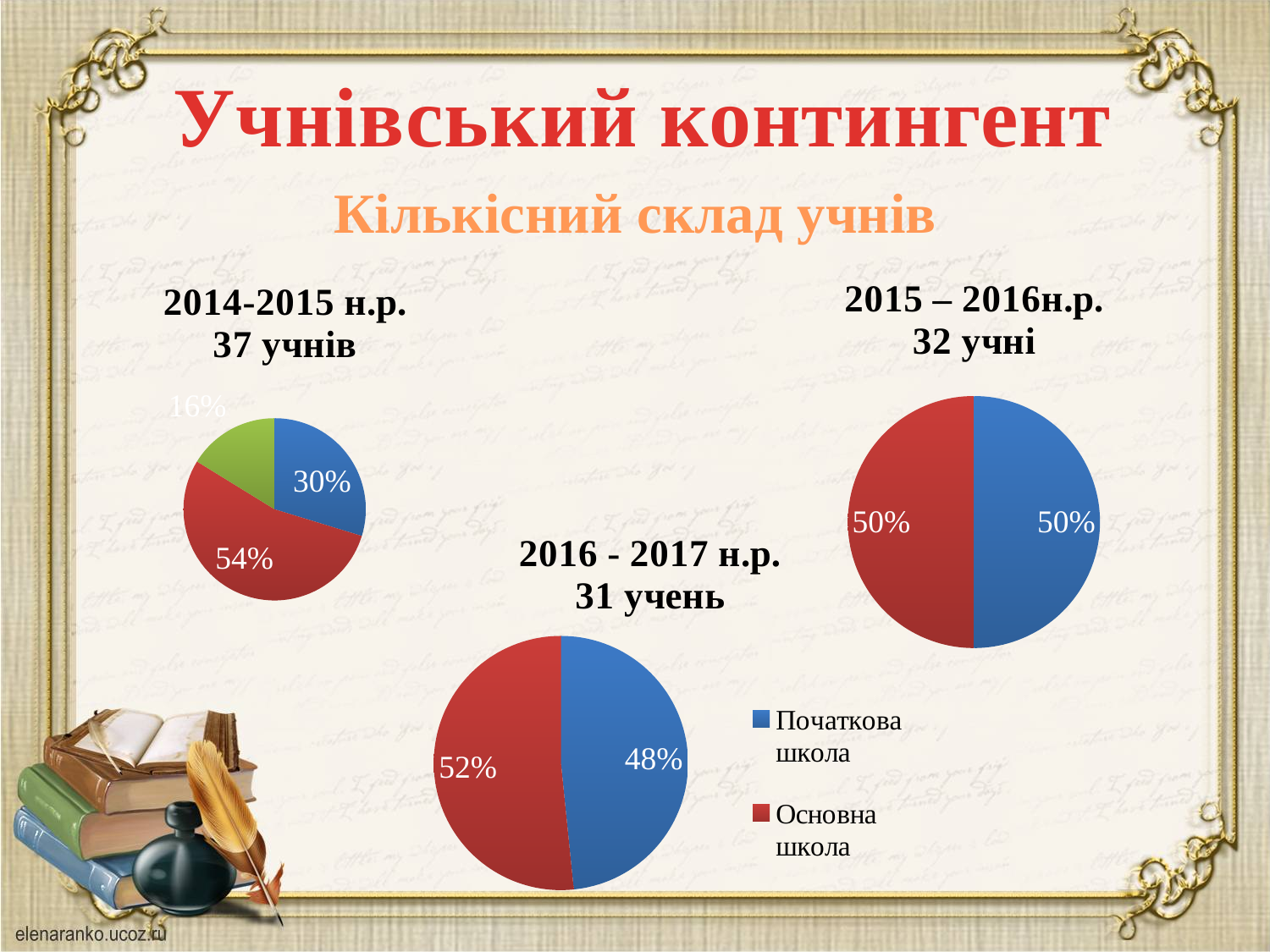
What kind of charts are shown on the slide? Pie charts How many pie charts are on the slide? 3 In the 2014-2015 н.р. pie chart, what share is shown for Початкова школа (blue slice)? 30% In the 2014-2015 н.р. pie chart, what share is shown for the green slice? 16% In the 2014-2015 н.р. pie chart, which slice is the largest? Основна школа (54%) In the 2014-2015 н.р. pie chart, which slice is the smallest? The green slice (16%) In the 2016 - 2017 н.р. pie chart, what share is shown for Основна школа? 52% In the 2016 - 2017 н.р. pie chart, what is the difference between the Основна школа and Початкова школа shares? 4 percentage points In the 2016 - 2017 н.р. pie chart, which is larger: Початкова школа or Основна школа? Основна школа How many entries does the legend list? 2 In the 2015 – 2016 н.р. pie chart, what share is shown for Початкова школа? 50% In the 2014-2015 н.р. pie chart, what share is shown for Основна школа (red slice)? 54%